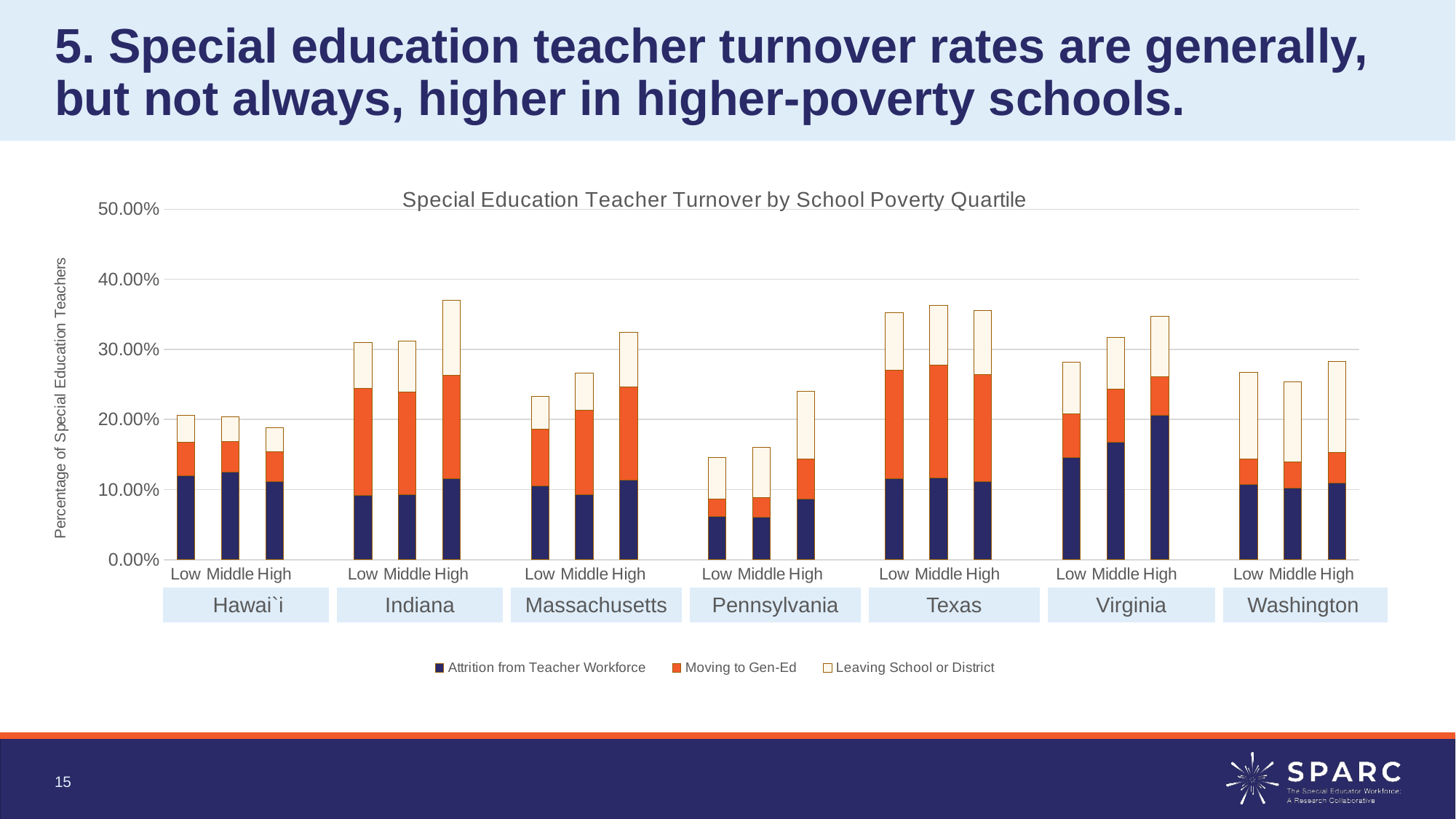
In Massachusetts, which quartile has the larger total turnover, Low or High? High What is the title of the chart? Special Education Teacher Turnover by School Poverty Quartile In Virginia, do total turnover rates rise or fall from the Low to the High poverty quartile? Rise Which state has the lowest total turnover for its Low poverty quartile? Pennsylvania What kind of chart is shown on the slide? Stacked bar chart Which series is shown in dark blue at the bottom of each bar? Attrition from Teacher Workforce Is the total turnover for the Low poverty quartile in Texas greater or less than 30.00%? greater Is the total turnover for the Low poverty quartile in Pennsylvania greater or less than 20.00%? less How many states are shown along the x axis? 7 How many bars are plotted in total? 21 Is the total turnover for the High poverty quartile in Indiana greater or less than 30.00%? greater How many series does the legend list? 3